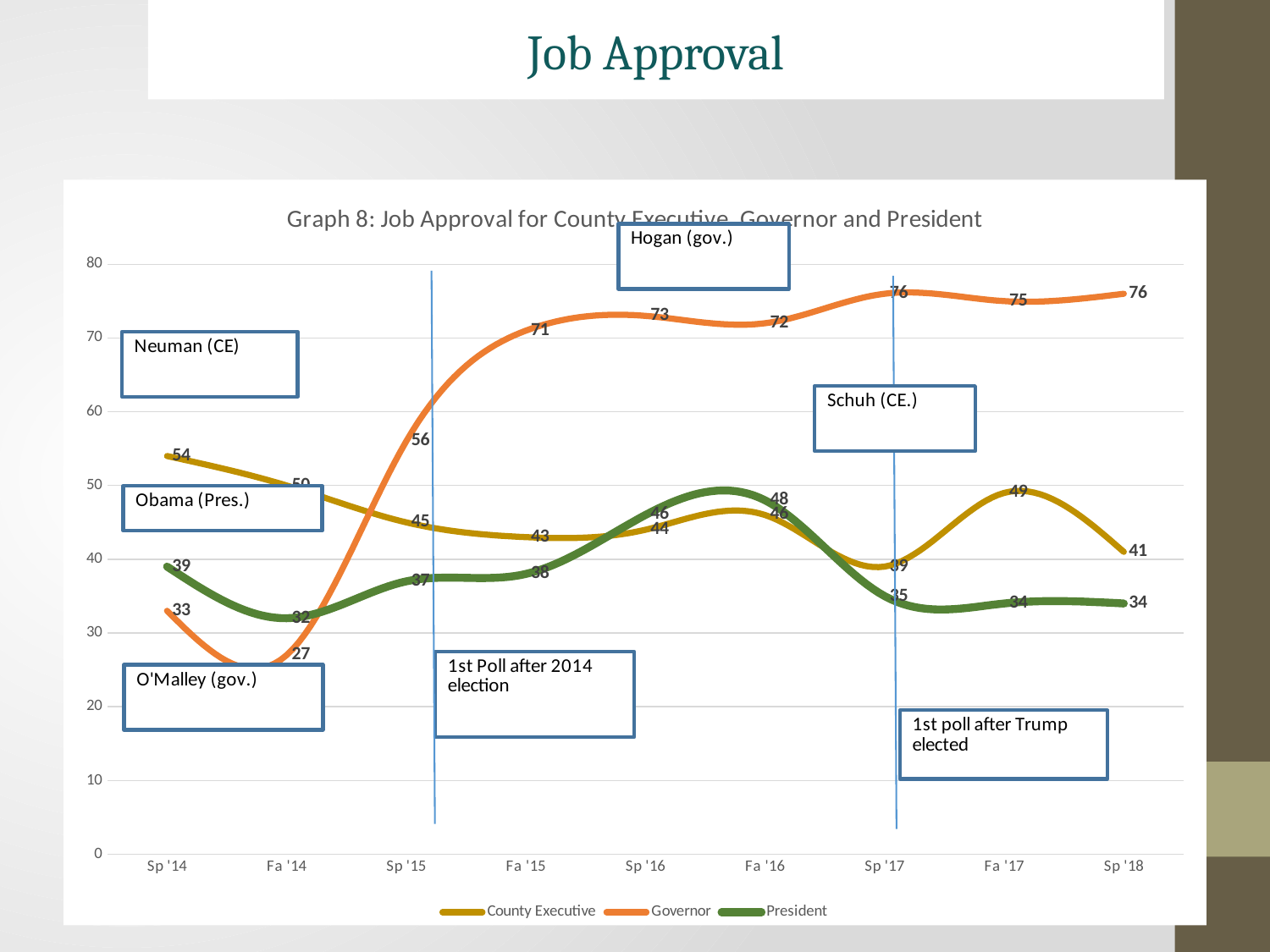
How many poll dates are shown on the x axis? 9 At Sp '18, which is higher: the Governor's or the President's job approval? Governor What is the Governor's job approval value at Sp '18? 76 At which poll is the County Executive's job approval highest? Sp '14 What kind of chart is shown on the slide? Line chart By how much did the Governor's job approval rise from Fa '14 to Sp '15? 29 What is the County Executive's job approval value at Sp '14? 54 What is the President's job approval value at Fa '16? 48 How many series does the legend list? 3 What is the Governor's job approval value at Fa '14? 27 Does the Governor's job approval rise or fall from Sp '14 to Fa '15? Rise At which poll is the Governor's job approval lowest? Fa '14